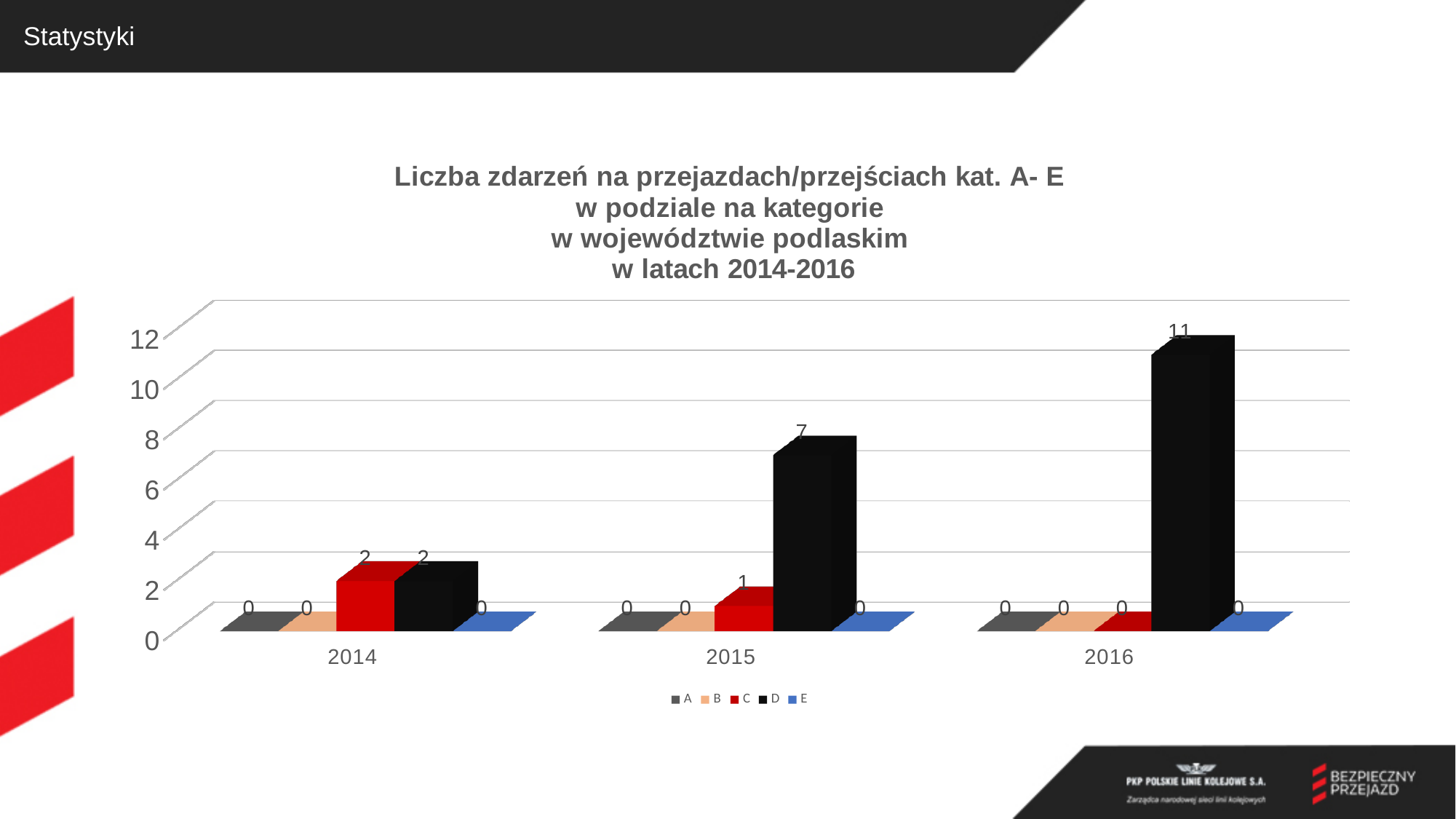
What is the value for category C in 2015? 1 What is the difference between the value for category D in 2016 and in 2015? 4 What is the value for category D in 2016? 11 What is the value for category D in 2015? 7 How many years are shown on the x axis? 3 What kind of chart is shown on the slide? bar chart Does the value for category D rise or fall from 2014 to 2016? rise In which year is the value for category D highest? 2016 What is the value for category C in 2014? 2 Is the value for category D in 2016 greater or less than 10? greater How many series does the legend list? 5 Which is larger: the value for category D in 2015 or the value for category C in 2015? D in 2015